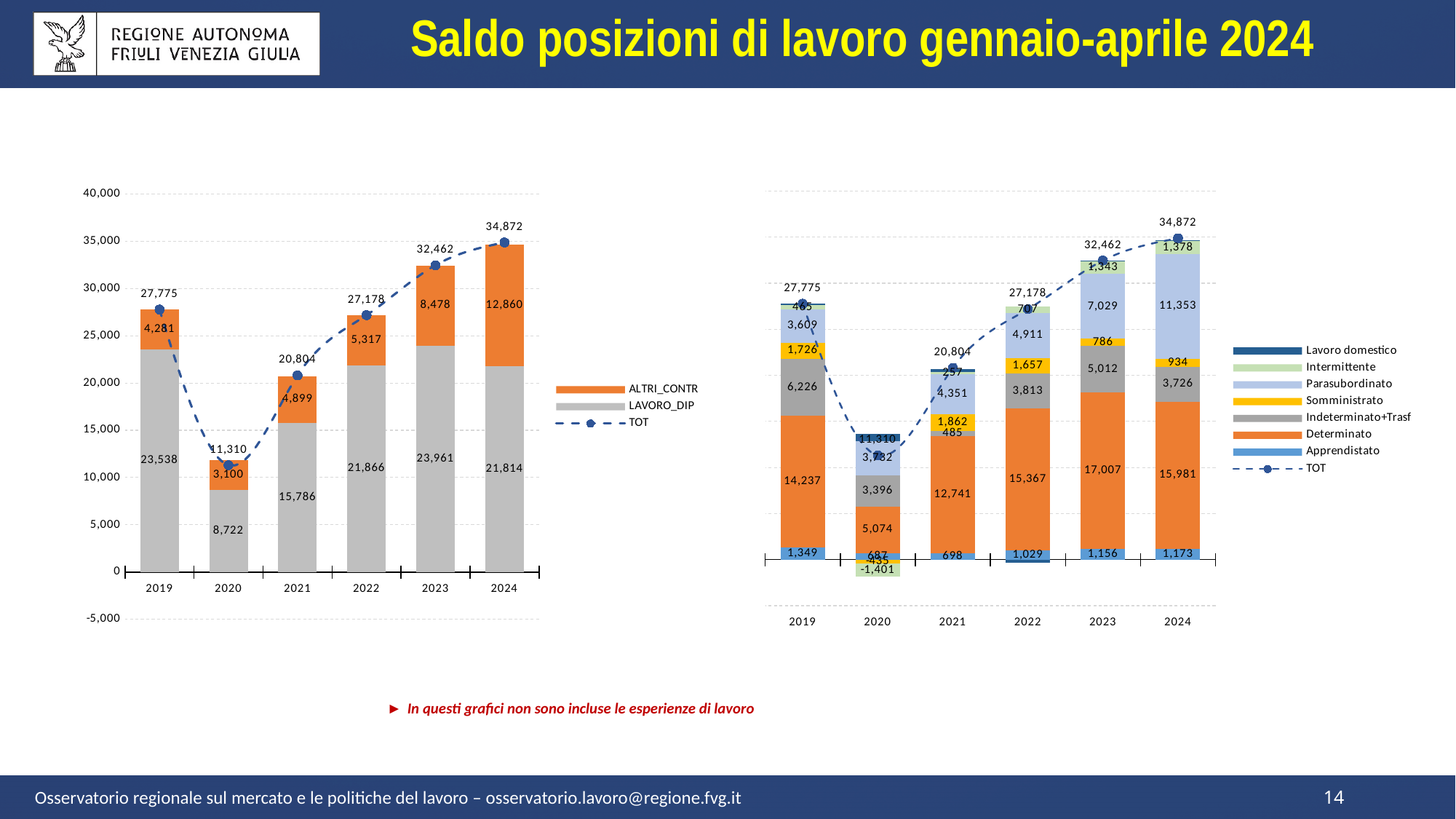
In the left chart, which year has the highest TOT value? 2024 In the left chart, how many series does the legend list? 3 In the left chart, what is the difference between the TOT values for 2024 and 2023? 2,410 In the left chart, is the LAVORO_DIP value for 2020 greater or less than 10,000? less In the right chart, which year has the highest Determinato value? 2023 In the right chart, what is the Determinato value for 2023? 17,007 In the left chart, which year has the lowest TOT value? 2020 In the left chart, what is the LAVORO_DIP value for 2019? 23,538 In the left chart, what is the ALTRI_CONTR value for 2024? 12,860 How many years are shown on the x axis of the right chart? 6 In the right chart, what is the Parasubordinato value for 2024? 11,353 In the right chart, is the Indeterminato+Trasf value larger in 2019 or in 2023? 2019